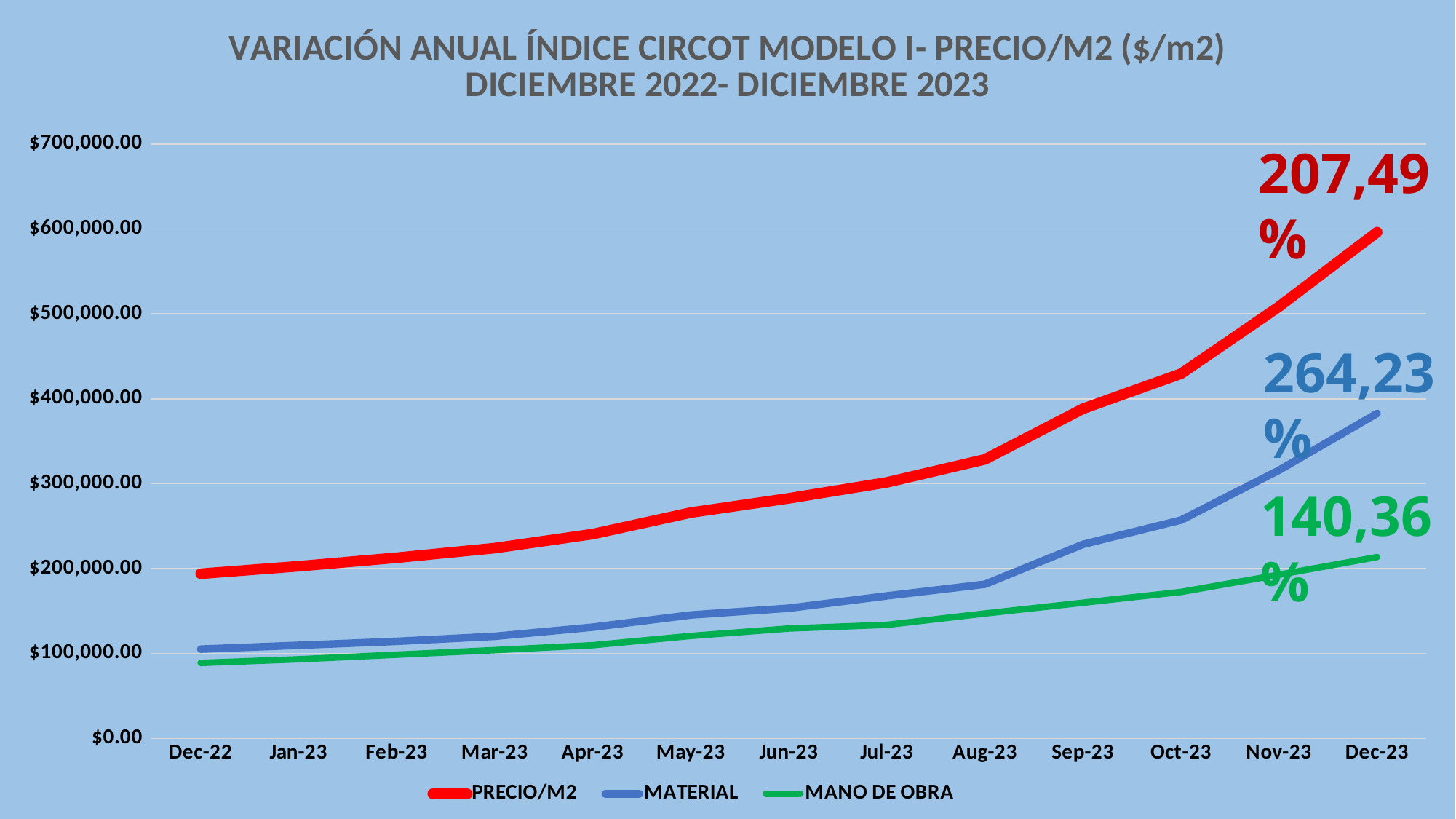
What kind of chart is shown on the slide? line chart At Aug-23, which is larger: MATERIAL or MANO DE OBRA? MATERIAL Is the value for PRECIO/M2 at Dec-23 greater or less than $500,000.00? greater Is the value for MATERIAL at Dec-23 greater or less than $400,000.00? less How many months are shown along the x axis? 13 Which series has the lowest value at Dec-22? MANO DE OBRA Is the value for PRECIO/M2 at Dec-22 greater or less than $100,000.00? greater How many series does the legend list? 3 Does the PRECIO/M2 series rise or fall from Dec-22 to Dec-23? rise What annual variation percentage is printed next to the MATERIAL line? 264,23% Which series has the highest value at Dec-23? PRECIO/M2